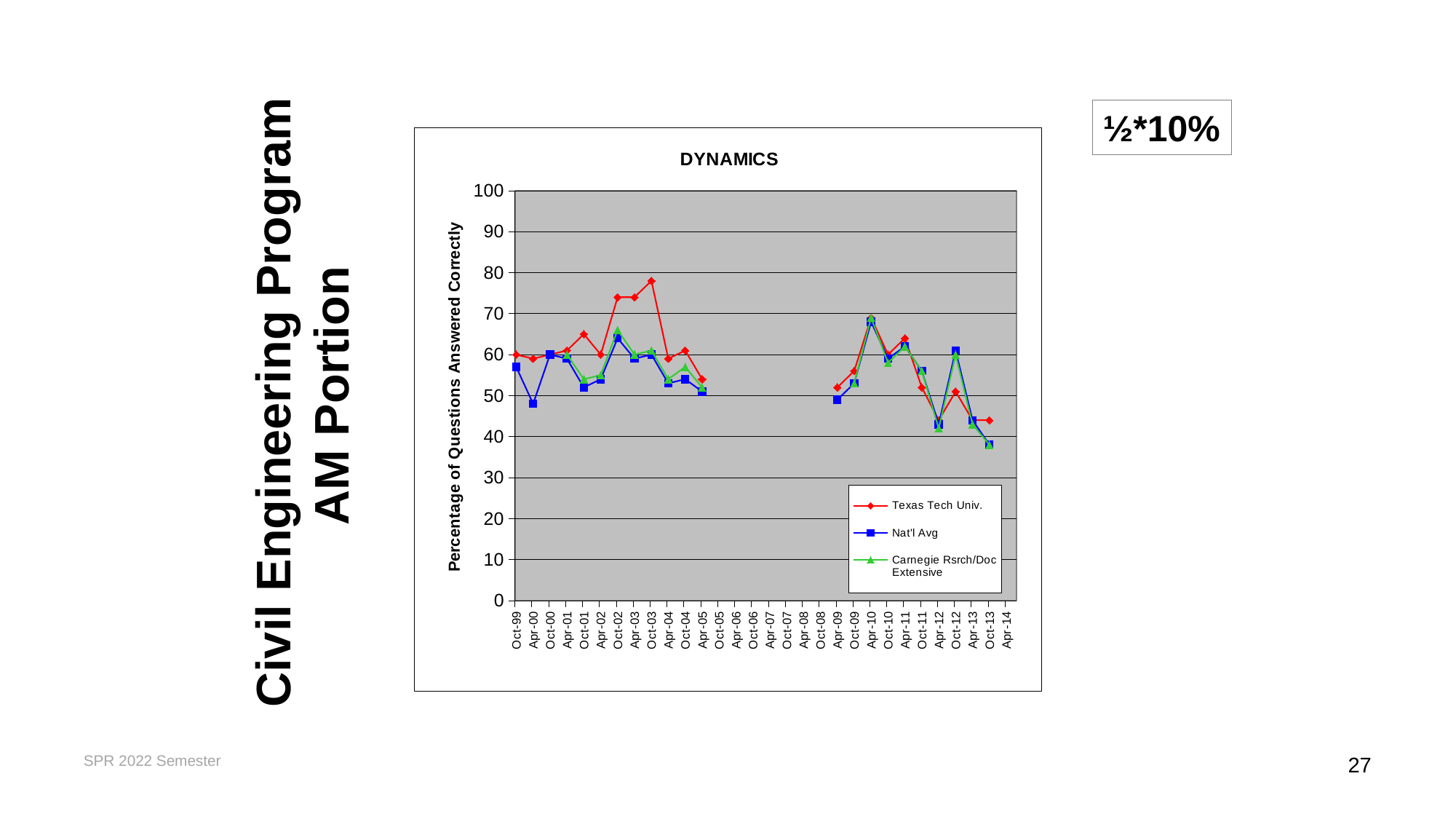
Is the Texas Tech Univ. value at Oct-03 greater or less than 70? greater What kind of chart is shown on the slide? Line chart How many series does the legend of the DYNAMICS chart list? 3 Is the Nat'l Avg value at Apr-10 greater or less than 60? greater What is the title of the chart? DYNAMICS At Oct-12, which is larger: the Texas Tech Univ. value or the Nat'l Avg value? Nat'l Avg At Oct-03, which is larger: the Texas Tech Univ. value or the Nat'l Avg value? Texas Tech Univ. How many date categories are shown along the x axis of the chart? 30 Is the Texas Tech Univ. value at Apr-12 greater or less than 50? less What is the label of the vertical axis of the chart? Percentage of Questions Answered Correctly Does the Texas Tech Univ. line rise or fall from Apr-11 to Apr-12? Fall Which series reaches the highest value anywhere on the chart? Texas Tech Univ.